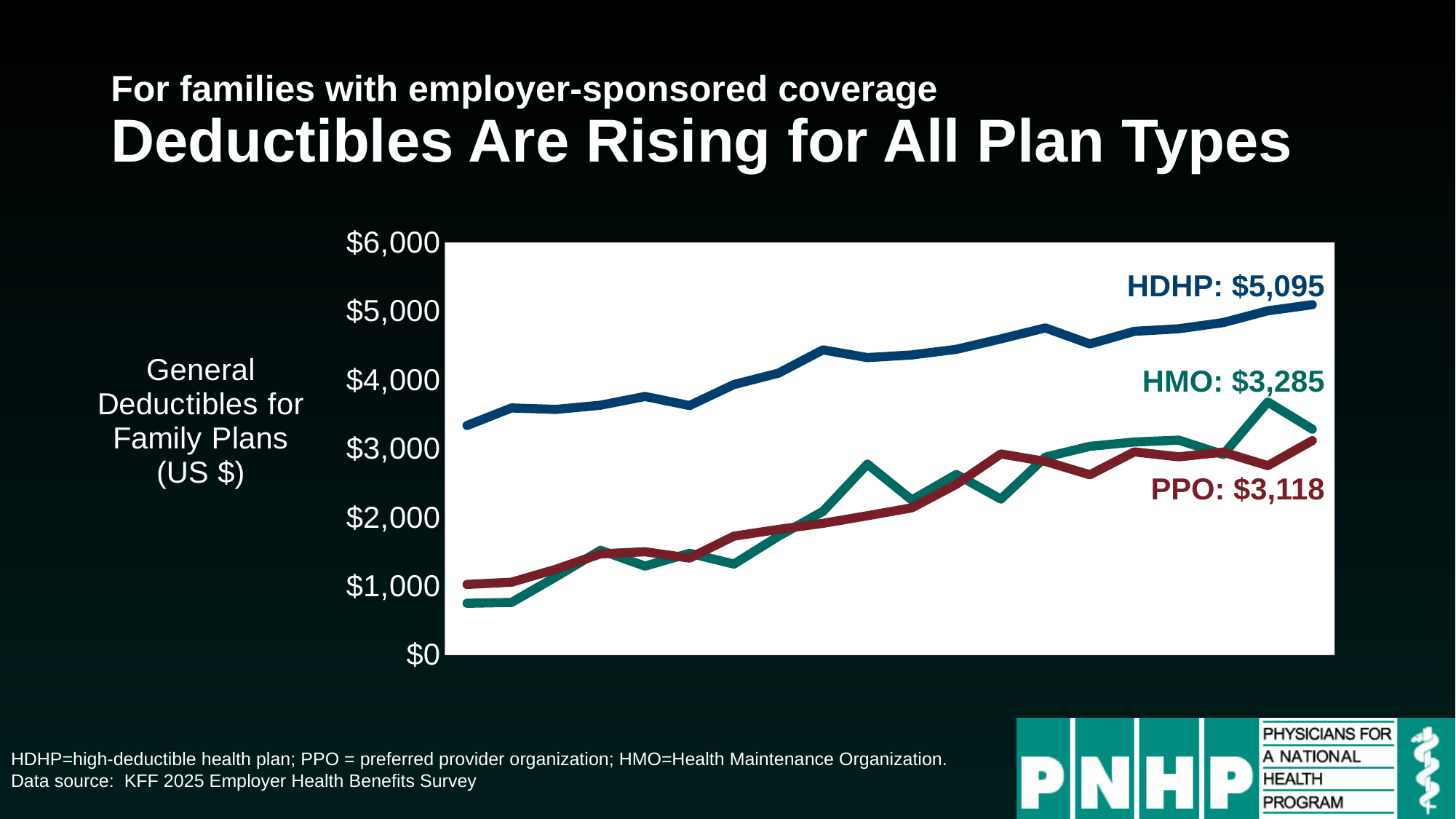
Which plan type has the lowest final deductible value? PPO What is the difference between the final HMO value and the final PPO value? $167 What kind of chart is shown on the slide? line chart Does the HDHP line generally rise or fall from left to right? rise Which plan type has the highest final deductible value? HDHP What is the final labeled value for PPO? $3,118 Is the starting value of the HMO line greater or less than $1,000? less Is the starting value of the HDHP line greater or less than $3,000? greater What is the final labeled value for HMO? $3,285 What is the final labeled value for HDHP? $5,095 What is the difference between the final HDHP value and the final HMO value? $1,810 Is the final HMO value larger or smaller than the final PPO value? larger